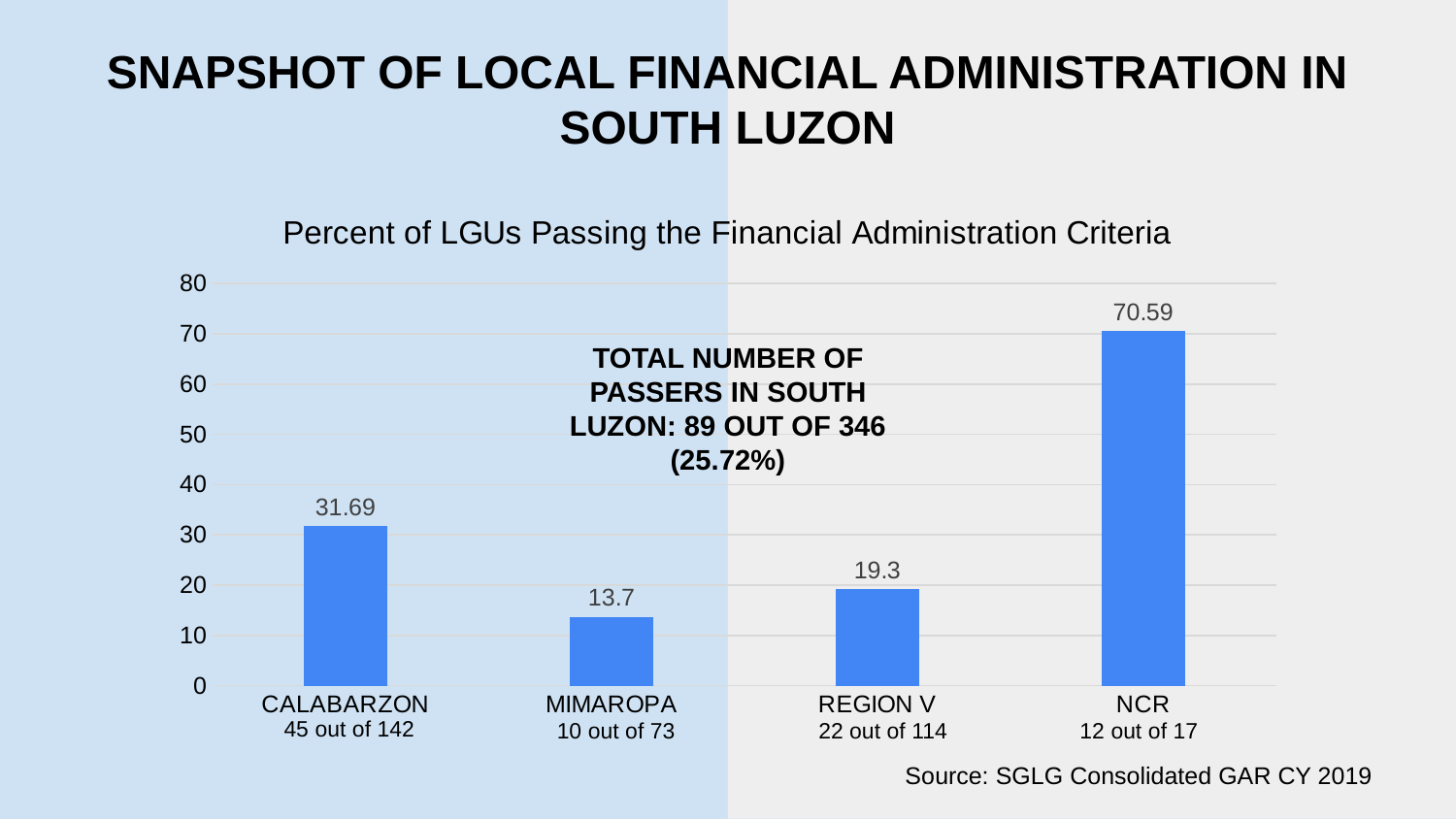
What is the difference between the values for NCR and CALABARZON? 38.9 Which region has the highest percent of LGUs passing the Financial Administration Criteria? NCR What kind of chart is shown on the slide? bar chart What is the value for REGION V? 19.3 What is the title of the chart? Percent of LGUs Passing the Financial Administration Criteria What is the value for CALABARZON? 31.69 Which is larger, the value for REGION V or the value for MIMAROPA? REGION V How many regions are shown in the chart? 4 Is the value for CALABARZON greater or less than 30? greater Which region has the lowest percent of LGUs passing the Financial Administration Criteria? MIMAROPA What is the value for MIMAROPA? 13.7 What is the value for NCR? 70.59